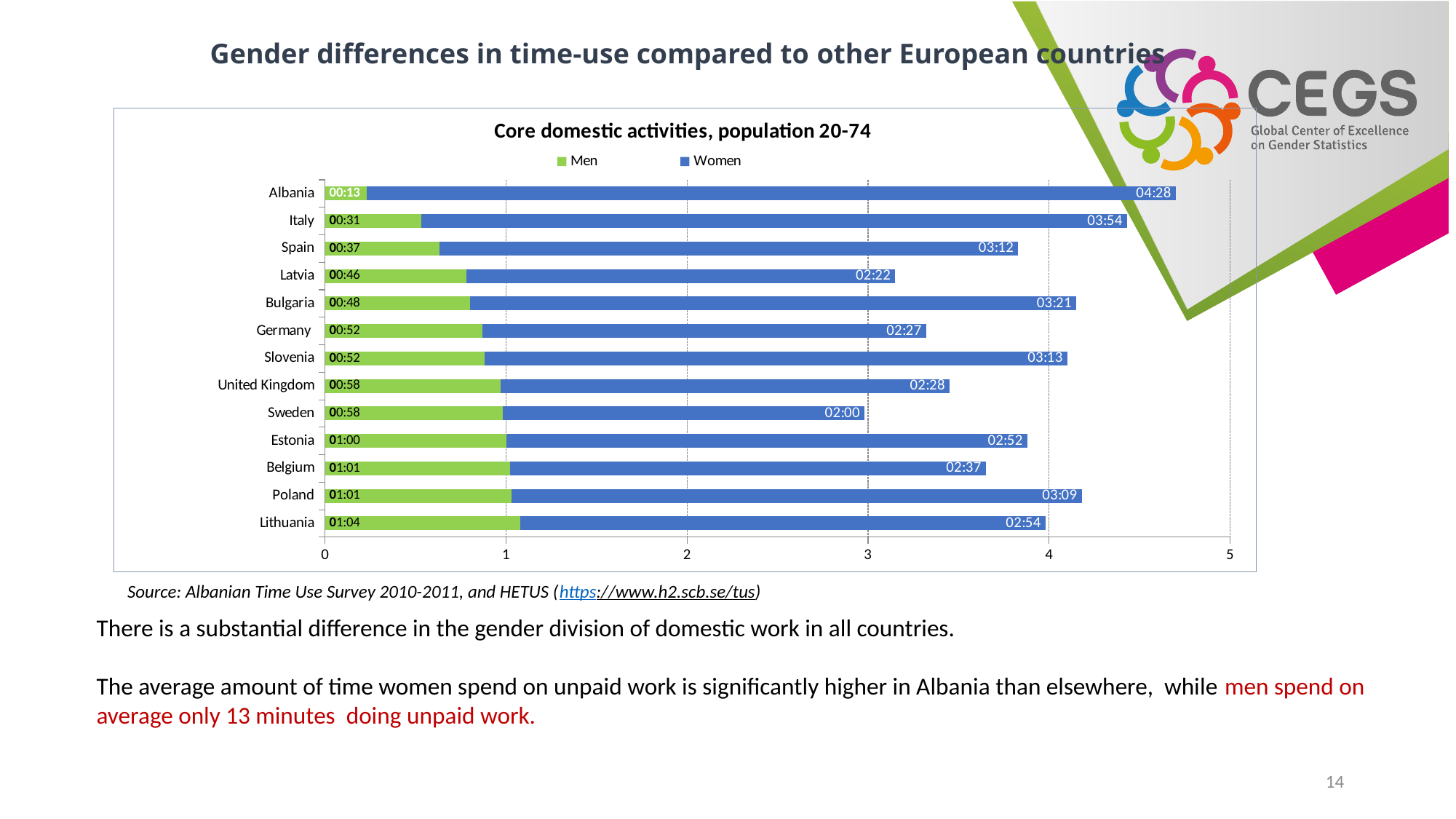
Which is larger, the Women value for Italy or the Women value for Spain? Italy What is the value for Men in Lithuania? 01:04 What is the title of the chart? Core domestic activities, population 20-74 What is the value for Women in Sweden? 02:00 Which country has the lowest value for Women? Sweden What kind of chart is shown on the slide? Stacked bar chart How many series does the legend list? 2 Which country has the lowest value for Men? Albania How many countries are shown in the chart? 13 What is the value for Women in Albania? 04:28 Which country has the highest value for Women? Albania What is the difference between the Women and Men values for Albania? 04:15